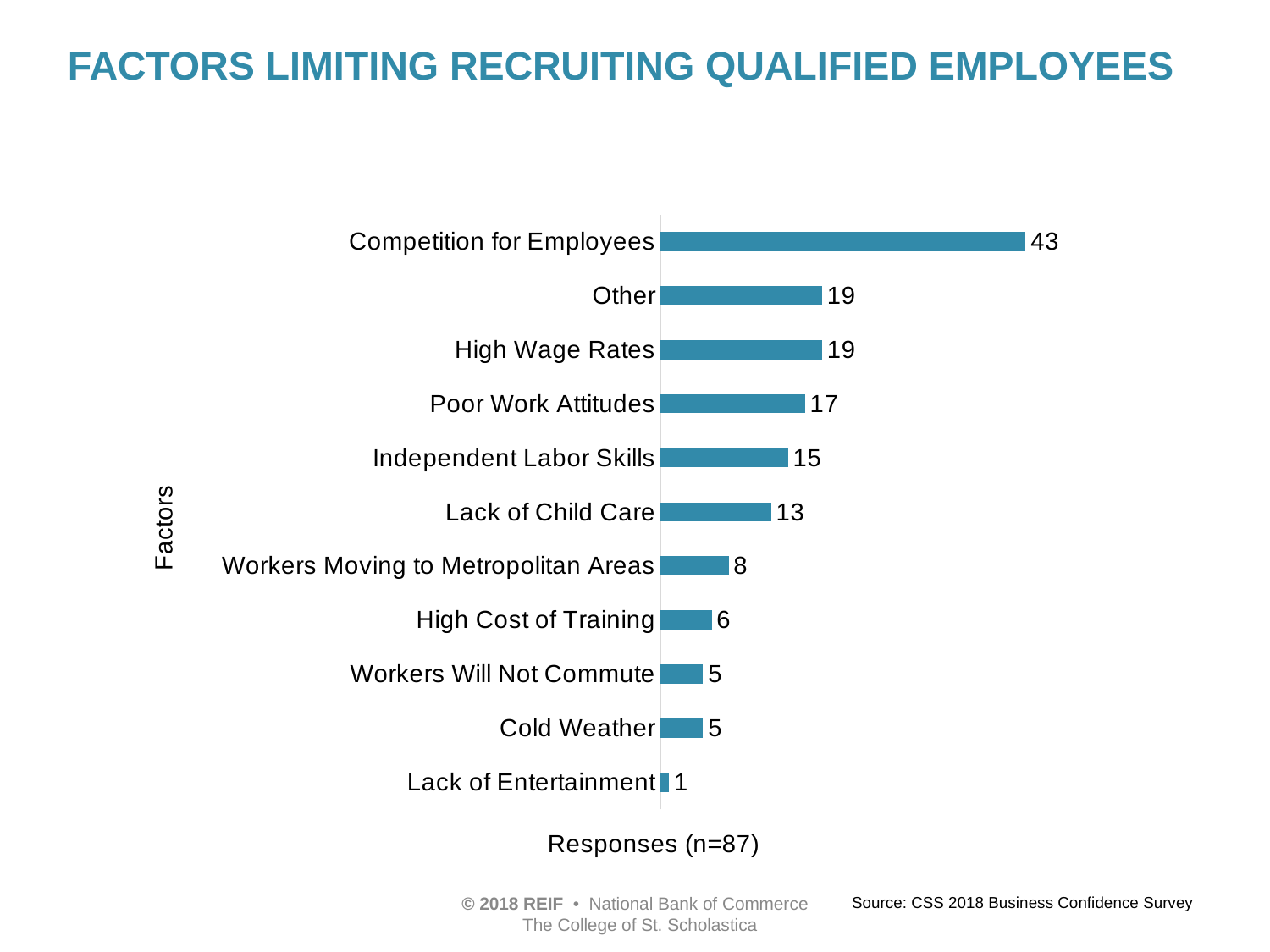
Which factor has the lowest number of responses? Lack of Entertainment What is the label of the horizontal axis? Responses (n=87) What is the number of responses for Lack of Child Care? 13 What is the difference in responses between Independent Labor Skills and Workers Moving to Metropolitan Areas? 7 What is the number of responses for High Cost of Training? 6 What is the title of the chart? Factors Limiting Recruiting Qualified Employees How many factors are shown in the chart? 11 What kind of chart is shown on the slide? Bar chart Which has more responses, Poor Work Attitudes or Lack of Child Care? Poor Work Attitudes Which factor has the highest number of responses? Competition for Employees What is the difference in responses between Competition for Employees and Poor Work Attitudes? 26 What is the number of responses for Competition for Employees? 43